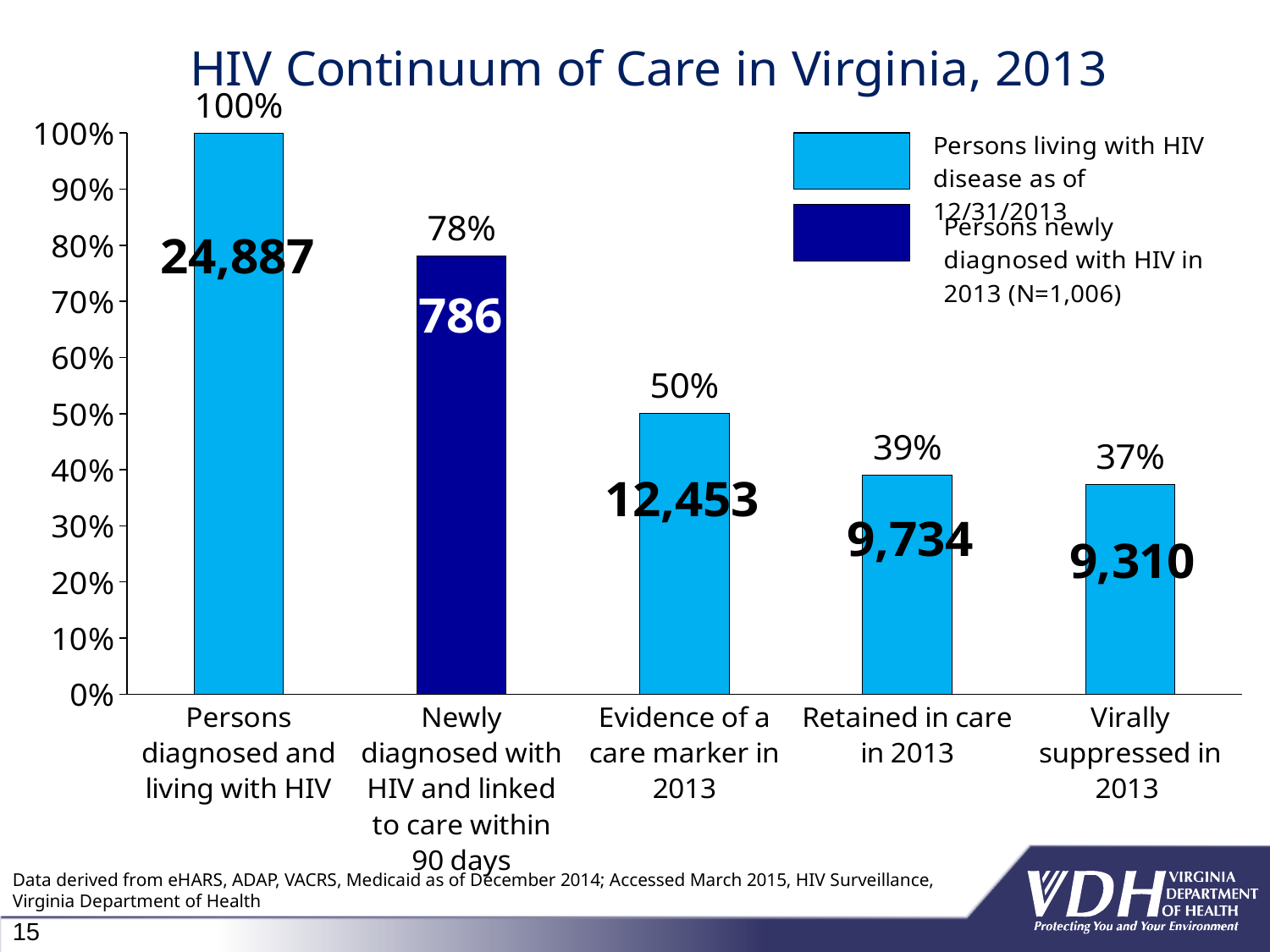
What is the difference in percentage points between 'Evidence of a care marker in 2013' and 'Retained in care in 2013'? 11% What count is printed on the bar for 'Newly diagnosed with HIV and linked to care within 90 days'? 786 What percentage is shown for 'Virally suppressed in 2013'? 37% What kind of chart is shown on the slide? Bar chart What is the title of the chart? HIV Continuum of Care in Virginia, 2013 Which category has the lowest percentage? Virally suppressed in 2013 What count is printed on the bar for 'Retained in care in 2013'? 9,734 Which category has the highest percentage? Persons diagnosed and living with HIV Which is larger, the percentage for 'Newly diagnosed with HIV and linked to care within 90 days' or for 'Evidence of a care marker in 2013'? Newly diagnosed with HIV and linked to care within 90 days What percentage is shown for 'Evidence of a care marker in 2013'? 50% How many categories are shown on the x axis? 5 How many series does the legend list? 2